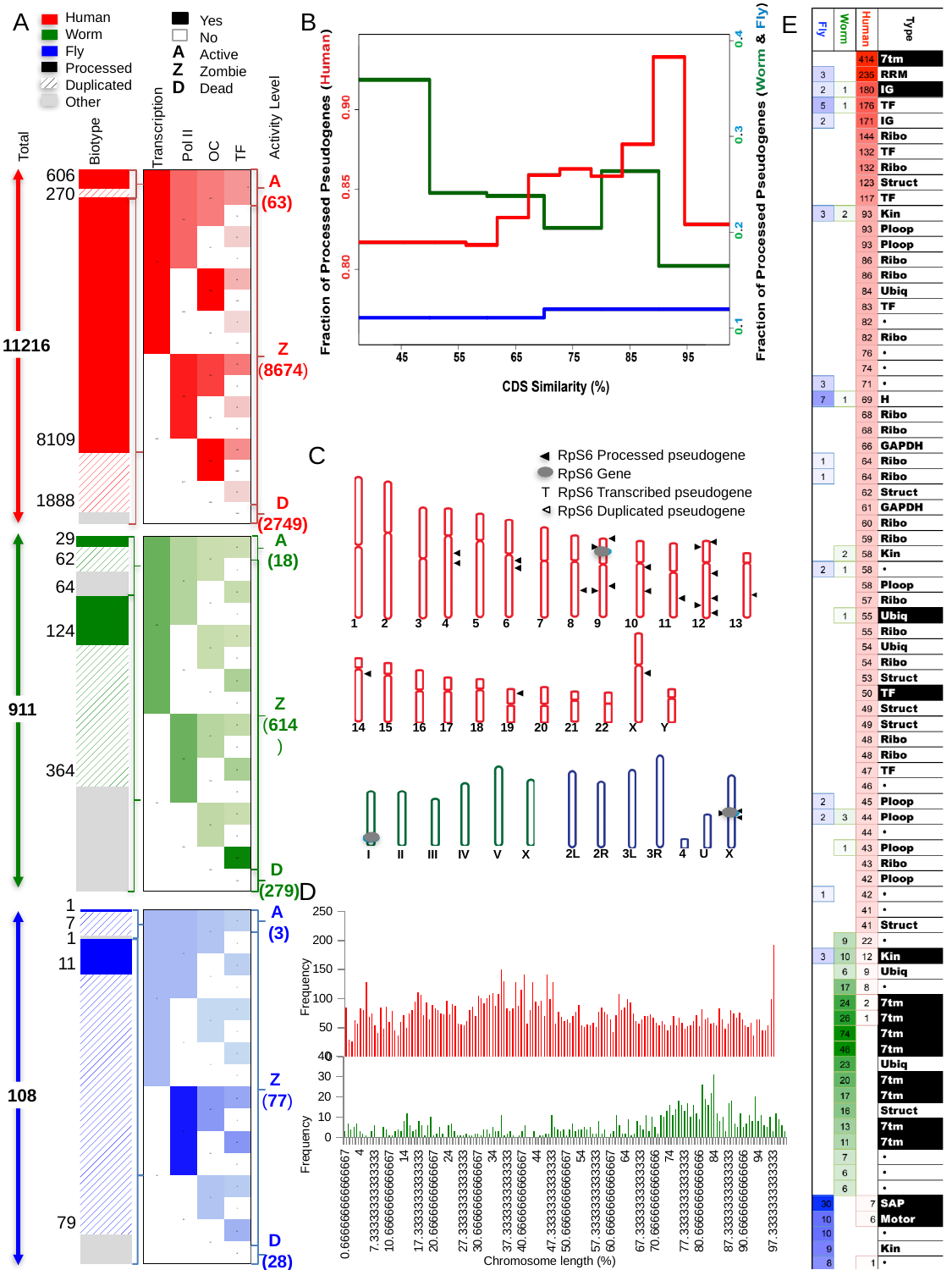
In panel A, how many fly pseudogenes are labelled Active (A)? 3 In panel A, how many human pseudogenes are labelled Dead (D)? 2749 In panel B, how many lines are plotted? 3 In panel A, how many human pseudogenes are labelled Zombie (Z)? 8674 In panel A, what is the total number of fly pseudogenes? 108 In panel A, what is the total number of worm pseudogenes? 911 In panel A, which worm activity level has more pseudogenes, Zombie or Dead? Zombie In panel B, what is the label of the x axis? CDS Similarity (%) What kind of chart is shown in panel D? bar chart In panel A, what is the total number of human pseudogenes shown on the left axis? 11216 In panel E, what is the human count for the type 7tm at the top of the table? 414 In panel A, what is the difference between the human Zombie count and the human Dead count? 5925